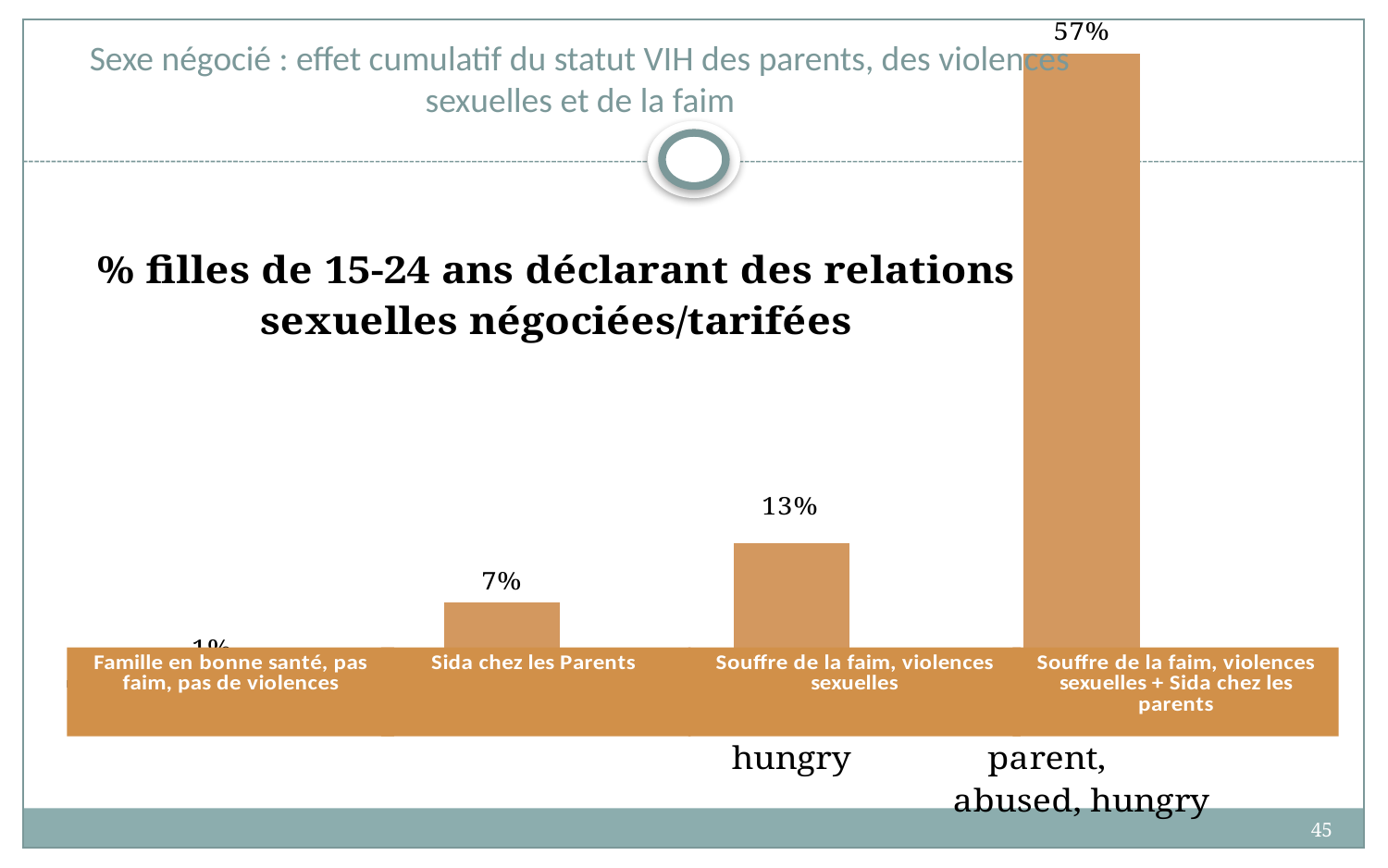
Which is larger: the value for 'Sida chez les Parents' or the value for 'Souffre de la faim, violences sexuelles'? Souffre de la faim, violences sexuelles Which category has the highest value? Souffre de la faim, violences sexuelles + Sida chez les parents What is the value for 'Souffre de la faim, violences sexuelles'? 13% Do the values rise or fall from left to right across the categories? rise What is the difference between the values for 'Souffre de la faim, violences sexuelles + Sida chez les parents' and 'Souffre de la faim, violences sexuelles'? 44 percentage points What is the value for 'Souffre de la faim, violences sexuelles + Sida chez les parents'? 57% What is the difference between the values for 'Souffre de la faim, violences sexuelles' and 'Sida chez les Parents'? 6 percentage points What is the value for 'Sida chez les Parents'? 7% What is the title of the chart? % filles de 15-24 ans déclarant des relations sexuelles négociées/tarifées Which category has the lowest value? Famille en bonne santé, pas faim, pas de violences How many categories are shown in the chart? 4 What type of chart is shown on the slide? bar chart